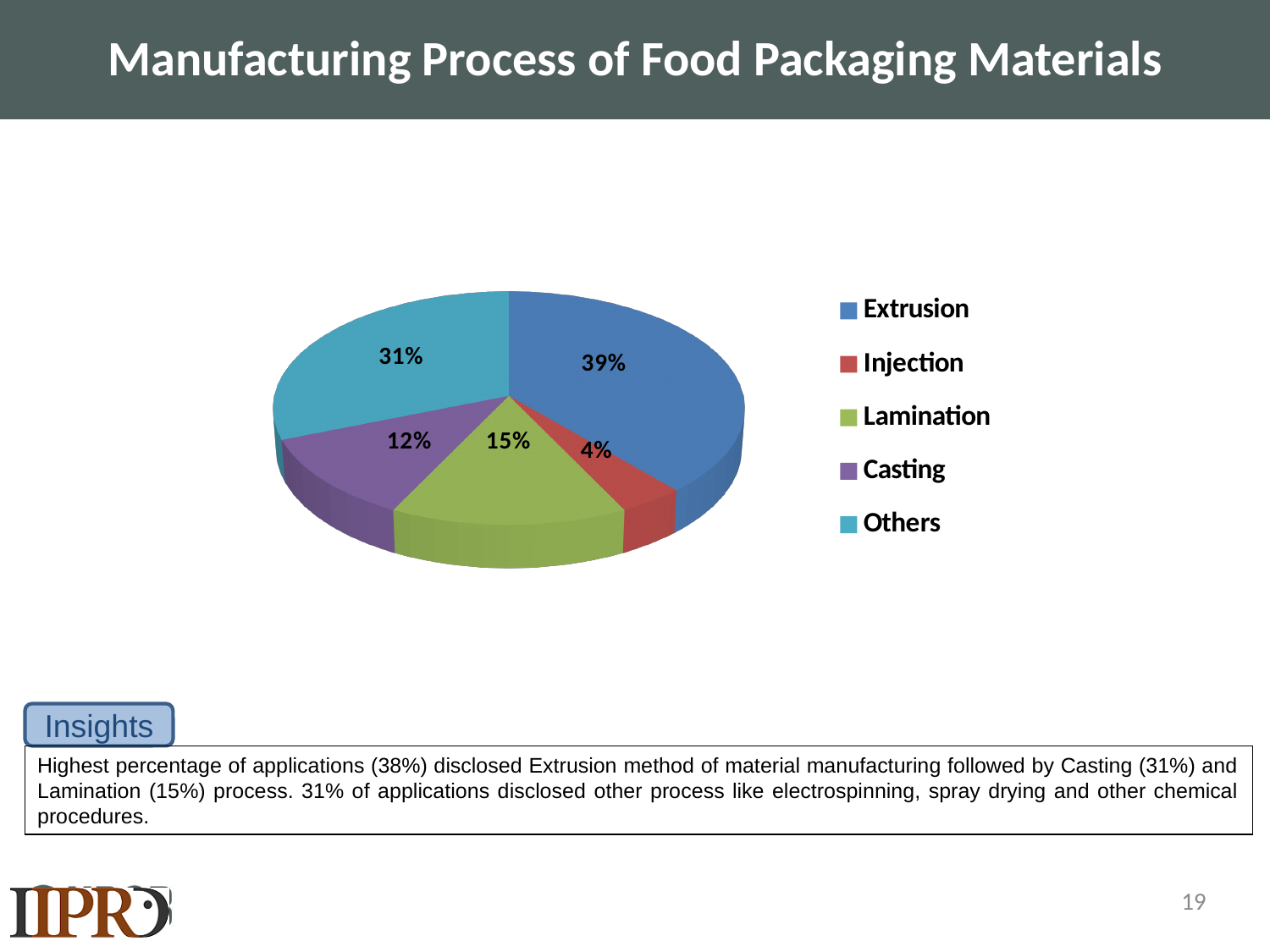
What percentage is shown for Casting? 12% What share of the pie does Others account for? 31% How many categories does the pie chart show? 5 Which is larger, the share for Lamination or the share for Casting? Lamination Which manufacturing process has the smallest slice of the pie? Injection What percentage is shown for Lamination? 15% Which manufacturing process has the largest slice of the pie? Extrusion What percentage is shown for Injection? 4% Which category is represented by the green slice? Lamination What is the difference in percentage points between Extrusion and Others? 8 What share of the pie does Extrusion account for? 39% What kind of chart is shown on the slide? Pie chart